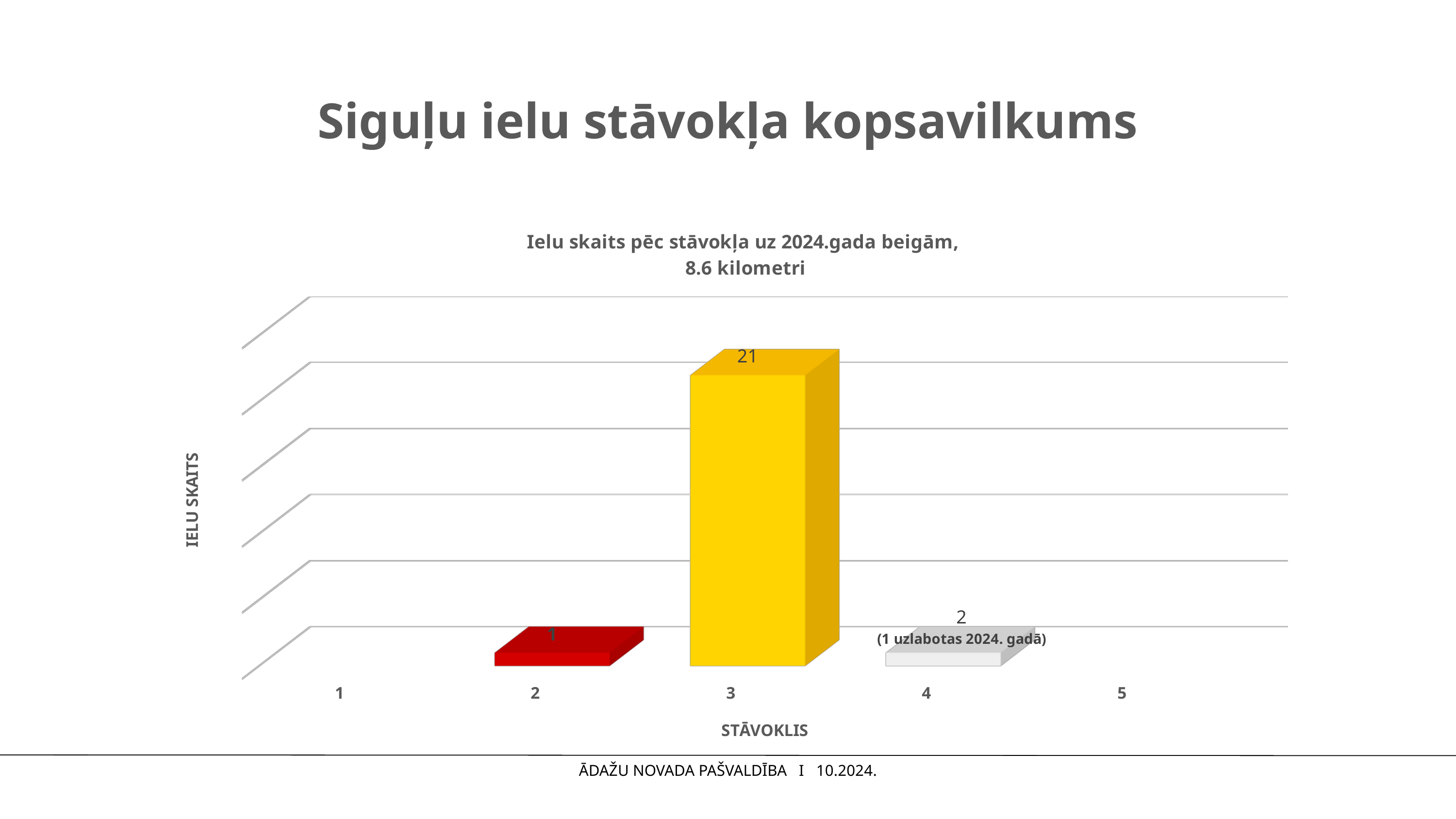
How many categories are shown on the x axis? 5 What is the value for category 4 (stāvoklis 4)? 2 Which category on the x axis has the highest value? 3 What is the difference between the values for category 3 and category 2? 20 What is the label of the y axis? IELU SKAITS Which is larger, the value for category 4 or the value for category 2? category 4 What is the label of the x axis? STĀVOKLIS What kind of chart is shown on the slide? bar chart What is the value for category 2 (stāvoklis 2)? 1 What is the value for category 3 (stāvoklis 3)? 21 Among the categories with a bar, which has the lowest value? 2 What is the difference between the values for category 3 and category 4? 19